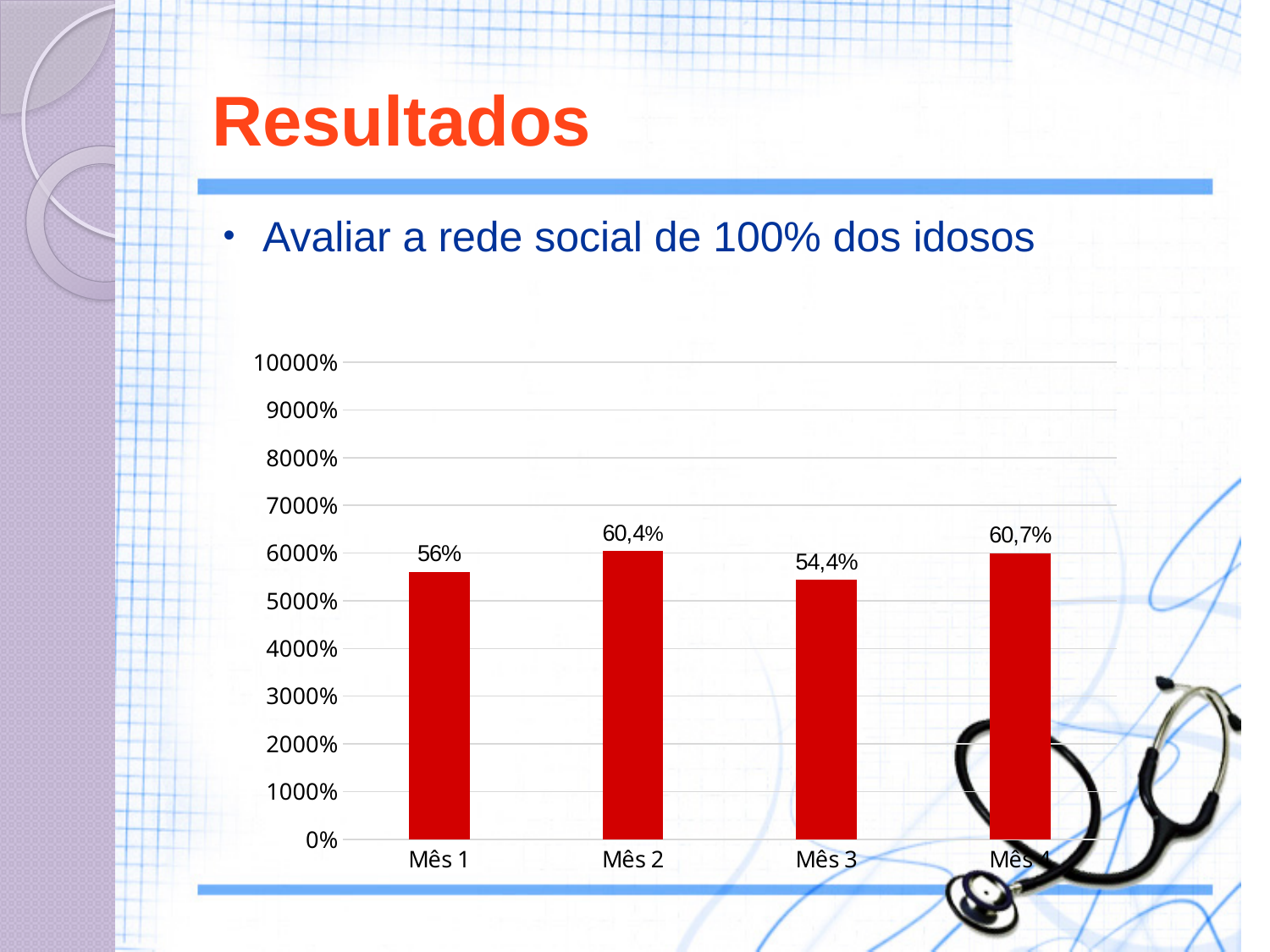
Which month has the lowest value? Mês 3 What is the difference between the values for Mês 2 and Mês 1? 4,4% What is the value for Mês 4? 60,7% How many months are shown on the x axis? 4 What kind of chart is shown on the slide? bar chart What is the value for Mês 2? 60,4% What is the difference between the values for Mês 4 and Mês 3? 6,3% What is the value for Mês 3? 54,4% Is the bar for Mês 3 greater or less than 6000% on the axis? less What is the value for Mês 1? 56% Which month has the highest value? Mês 4 Which is larger, the value for Mês 1 or the value for Mês 3? Mês 1